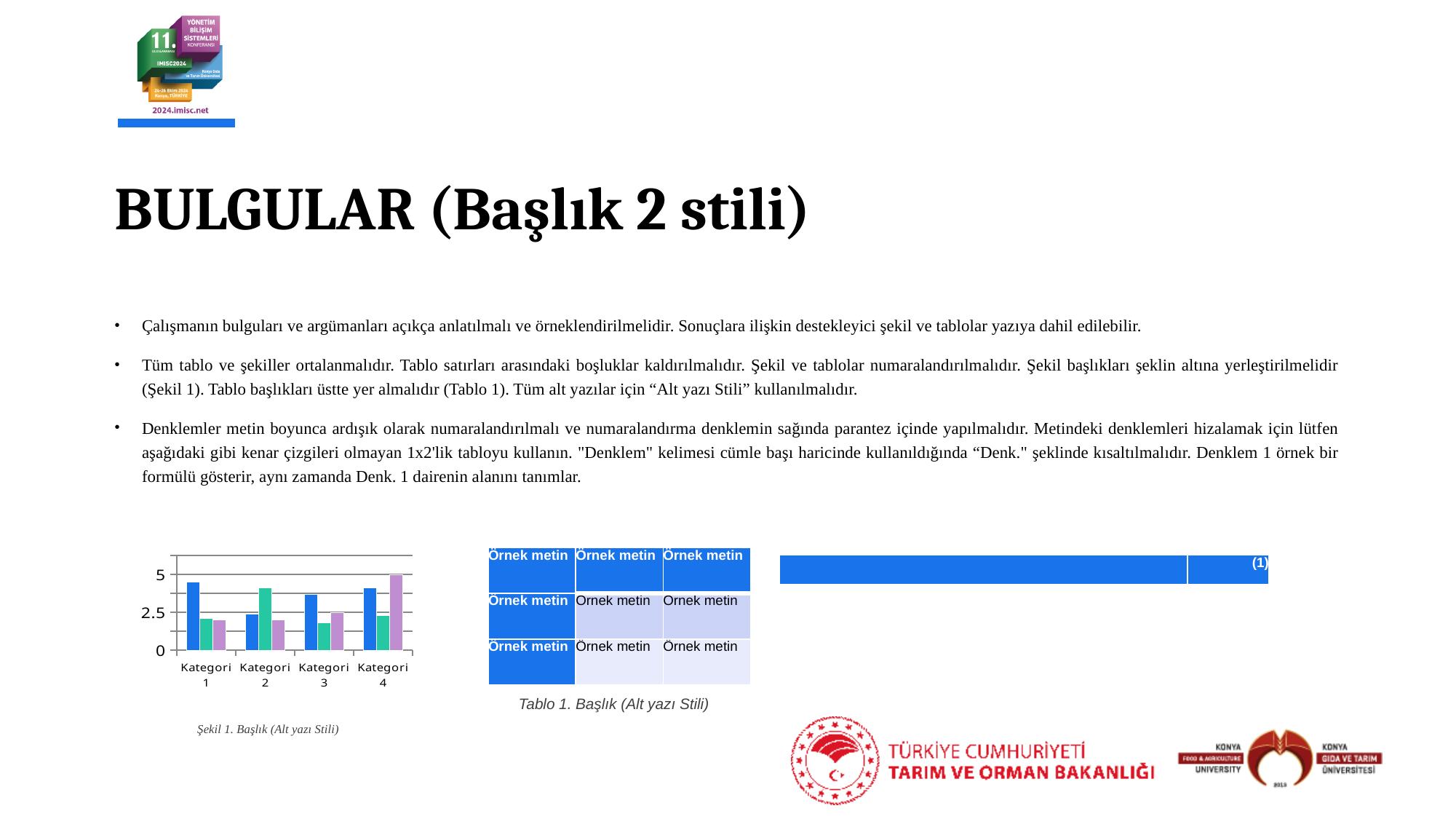
What kind of chart is shown in Şekil 1? bar chart How many categories are shown on the x axis of the bar chart? 4 Is the value of the purple bar for Kategori 1 greater or less than 2.5? less For Kategori 1, which bar is taller, the blue bar or the green bar? the blue bar In which category is the purple bar the tallest? Kategori 4 Is the value of the blue bar for Kategori 1 greater or less than 2.5? greater For Kategori 2, which bar is taller, the blue bar or the green bar? the green bar What is the caption written below the bar chart? Şekil 1. Başlık (Alt yazı Stili) In which category is the green bar the shortest? Kategori 3 How many bars are plotted for each category in the bar chart? 3 Is the value of the green bar for Kategori 3 greater or less than 2.5? less